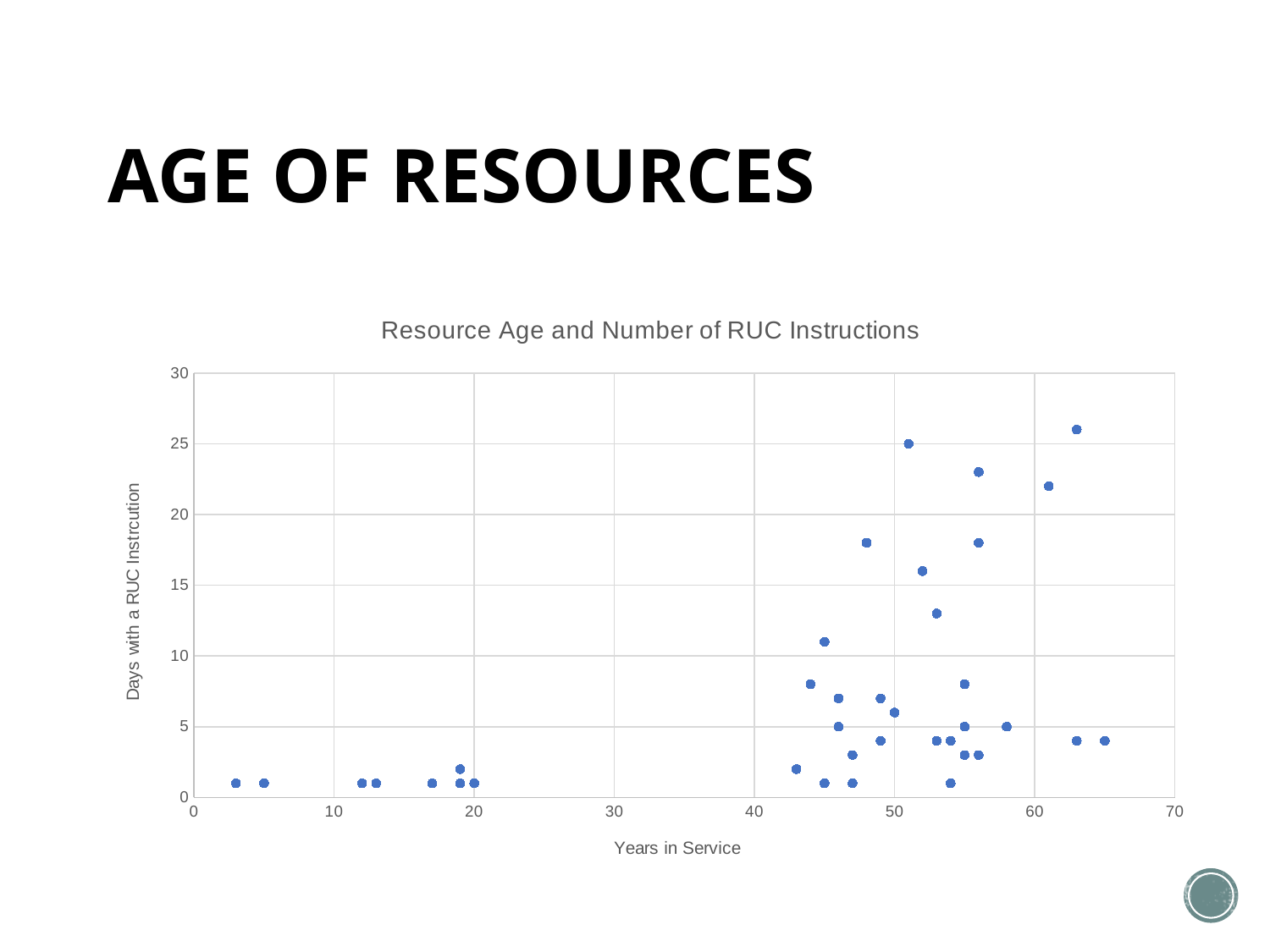
Is the lowest Days with a RUC Instruction value on the chart greater or less than 5? less What is the label of the x axis? Years in Service What kind of chart is shown on the slide? scatter chart Are the Days with a RUC Instruction values for all points with fewer than 30 Years in Service greater or less than 5? less Do the Days with a RUC Instruction values generally rise or fall as Years in Service increases? rise Is the point with the highest Days with a RUC Instruction value located at a Years in Service value greater or less than 60? greater What is the title of the chart? Resource Age and Number of RUC Instructions How many points are plotted with Years in Service between 20 and 40? 0